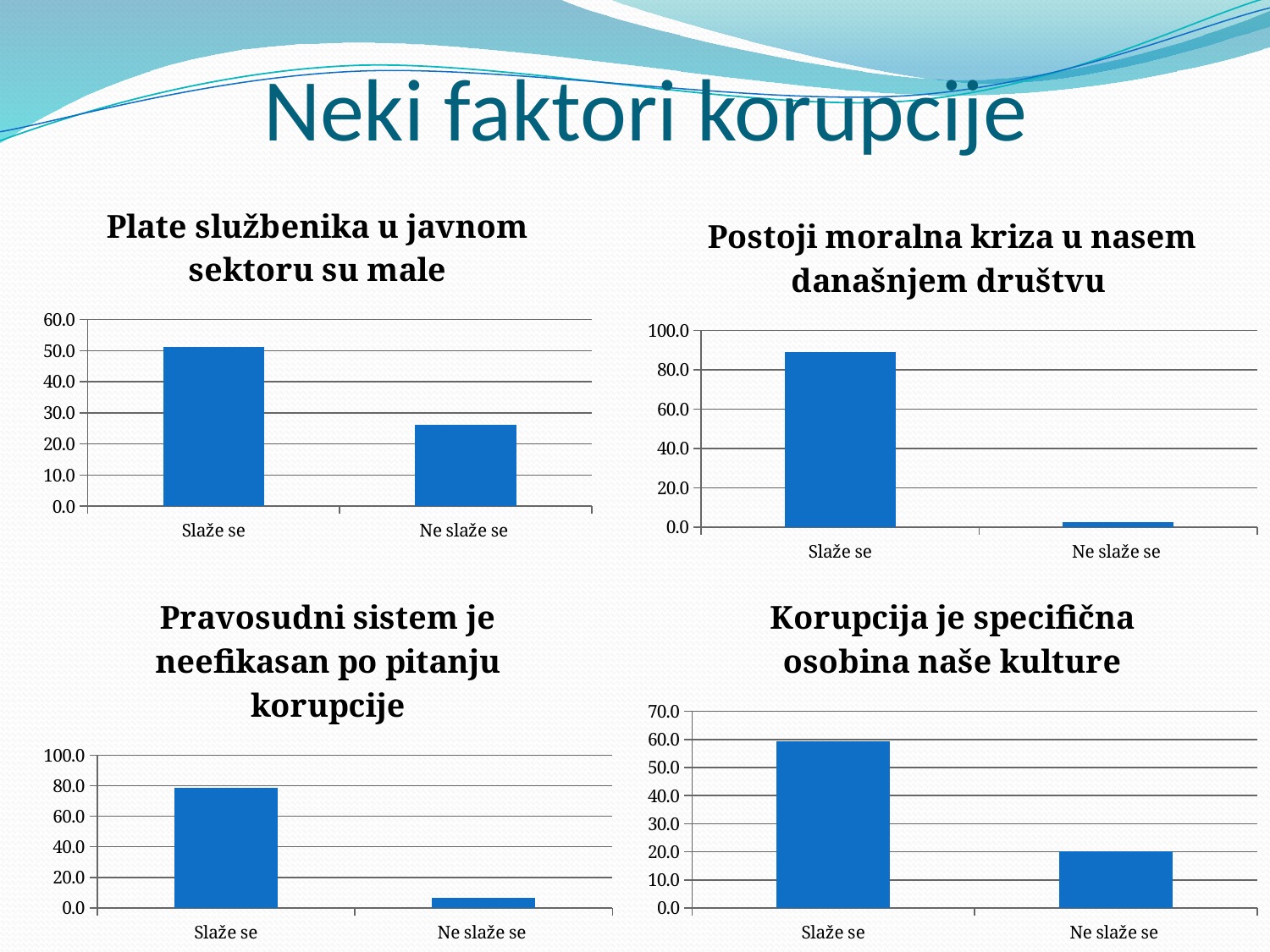
In the chart titled "Pravosudni sistem je neefikasan po pitanju korupcije", which is larger, Slaže se or Ne slaže se? Slaže se In the chart titled "Plate službenika u javnom sektoru su male", is the value for Ne slaže se greater or less than 30.0? less How many categories are shown in the chart titled "Korupcija je specifična osobina naše kulture"? 2 In the chart titled "Postoji moralna kriza u nasem današnjem društvu", which category has the lowest value? Ne slaže se In the chart titled "Korupcija je specifična osobina naše kulture", is the value for Slaže se greater or less than 50.0? greater In the chart titled "Pravosudni sistem je neefikasan po pitanju korupcije", is the value for Slaže se greater or less than 60.0? greater In the chart titled "Plate službenika u javnom sektoru su male", which category has the highest value? Slaže se What kind of chart is the chart titled "Pravosudni sistem je neefikasan po pitanju korupcije"? bar chart